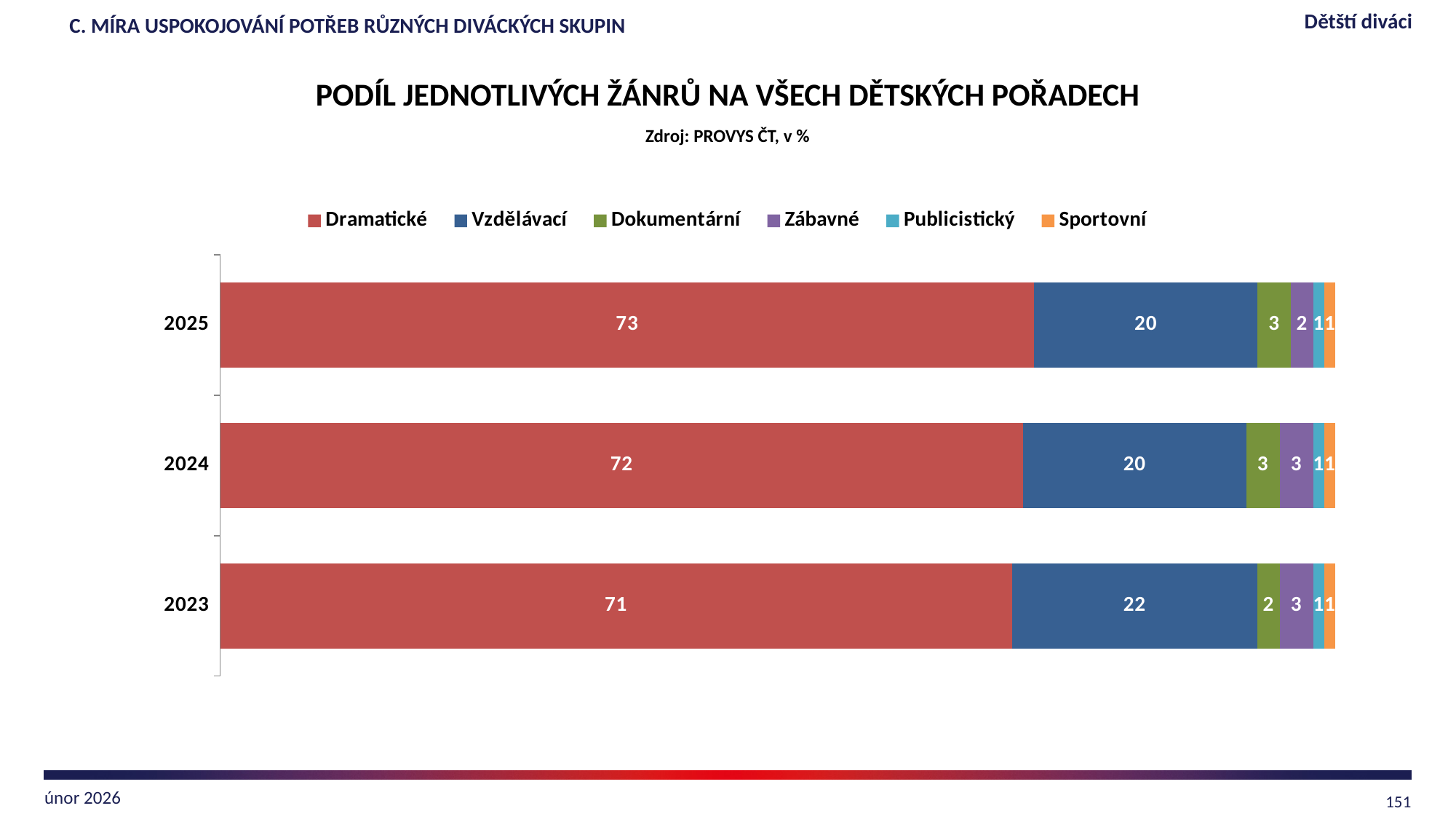
What is the difference between the Dramatické values for 2025 and 2023? 2 What is the total of the stacked bar for 2024? 100 What is the value for Dokumentární in 2023? 2 What is the value for Dramatické in 2025? 73 How many years are shown on the chart? 3 What is the value for Zábavné in 2024? 3 In which year is the Dramatické value highest? 2025 How many series does the legend list? 6 What kind of chart is shown on the slide? Stacked bar chart What is the value for Vzdělávací in 2023? 22 In which year is the Dramatické value lowest? 2023 Which is larger, the Vzdělávací value for 2023 or for 2025? 2023